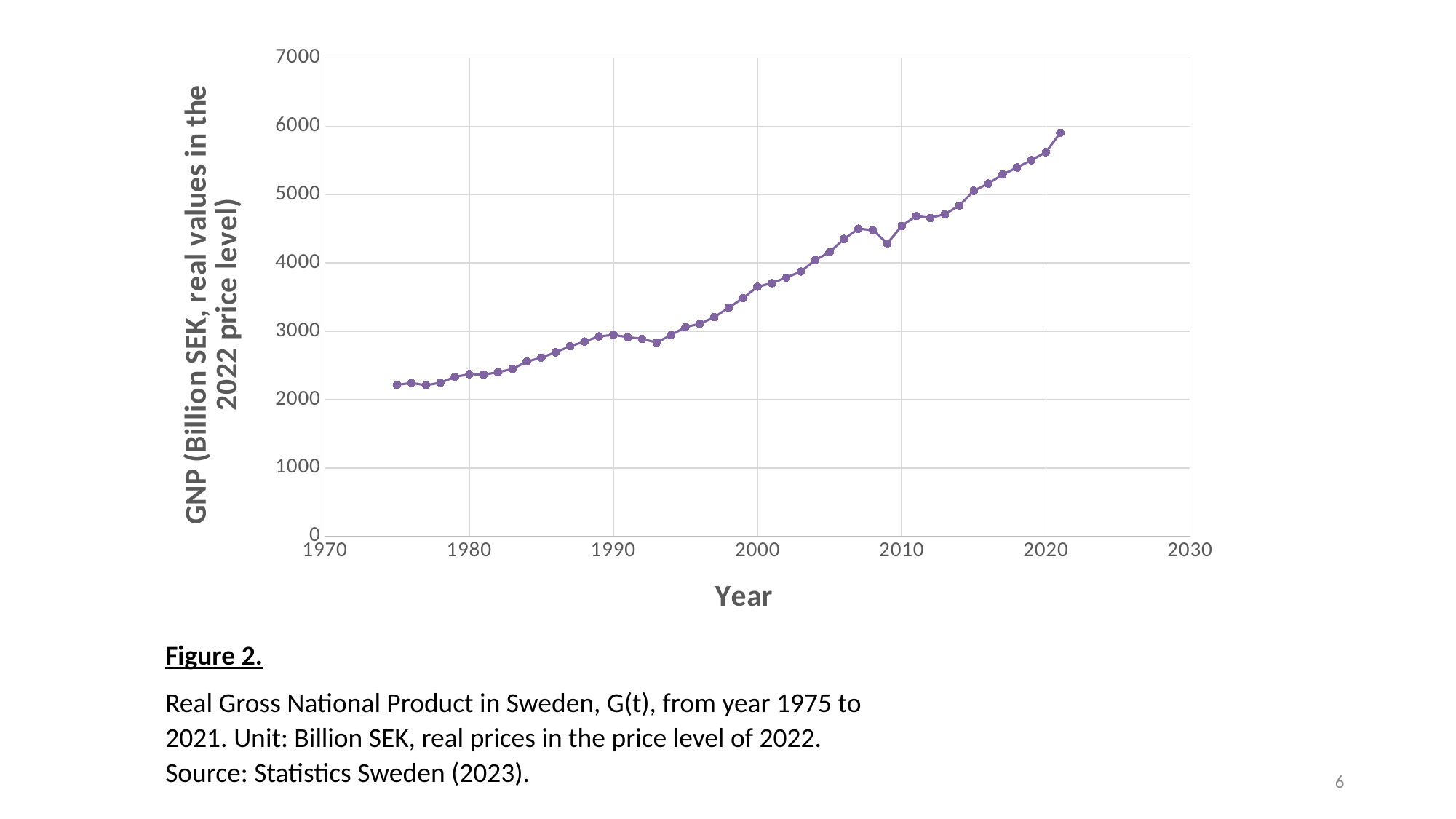
Which year has the highest GNP value in the chart? 2021 Is the GNP value for 1975 greater or less than 2000? greater Is the GNP value for 1980 greater or less than 3000? less Is the GNP value for 2000 greater or less than 4000? less Which year has the larger GNP value, 1975 or 2021? 2021 Which year has the larger GNP value, 2008 or 2009? 2008 Overall, does GNP rise or fall from 1975 to 2021 along the x axis? Rise What is the label of the x axis? Year What kind of chart is shown on the slide? Line chart What is the label of the y axis? GNP (Billion SEK, real values in the 2022 price level)